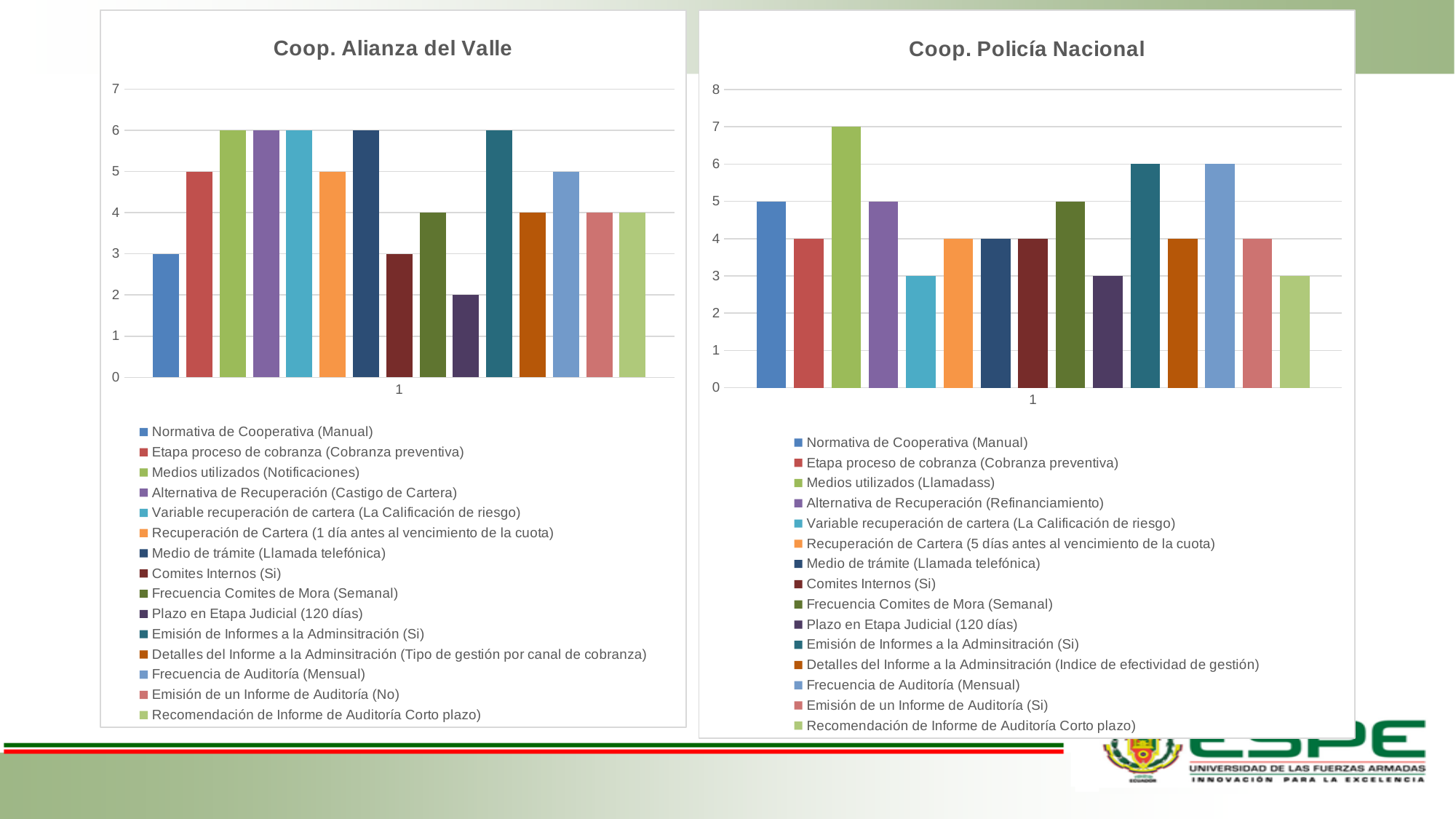
How many series does the legend of the Coop. Alianza del Valle chart list? 15 How many series does the legend of the Coop. Policía Nacional chart list? 15 In the Coop. Alianza del Valle chart, what is the difference between Etapa proceso de cobranza (Cobranza preventiva) and Comites Internos (Si)? 2 In the Coop. Policía Nacional chart, what is the value for Plazo en Etapa Judicial (120 días)? 3 What kind of chart is the Coop. Policía Nacional chart? Bar chart In the Coop. Alianza del Valle chart, what is the value for Frecuencia de Auditoría (Mensual)? 5 What is the title of the chart on the left side of the slide? Coop. Alianza del Valle In the Coop. Policía Nacional chart, which series has the highest value? Medios utilizados (Llamadass) In the Coop. Alianza del Valle chart, which series has the lowest value? Plazo en Etapa Judicial (120 días) In the Coop. Policía Nacional chart, which is larger: Normativa de Cooperativa (Manual) or Variable recuperación de cartera (La Calificación de riesgo)? Normativa de Cooperativa (Manual) In the Coop. Policía Nacional chart, what is the value for Medios utilizados (Llamadass)? 7 In the Coop. Alianza del Valle chart, what is the value for Normativa de Cooperativa (Manual)? 3